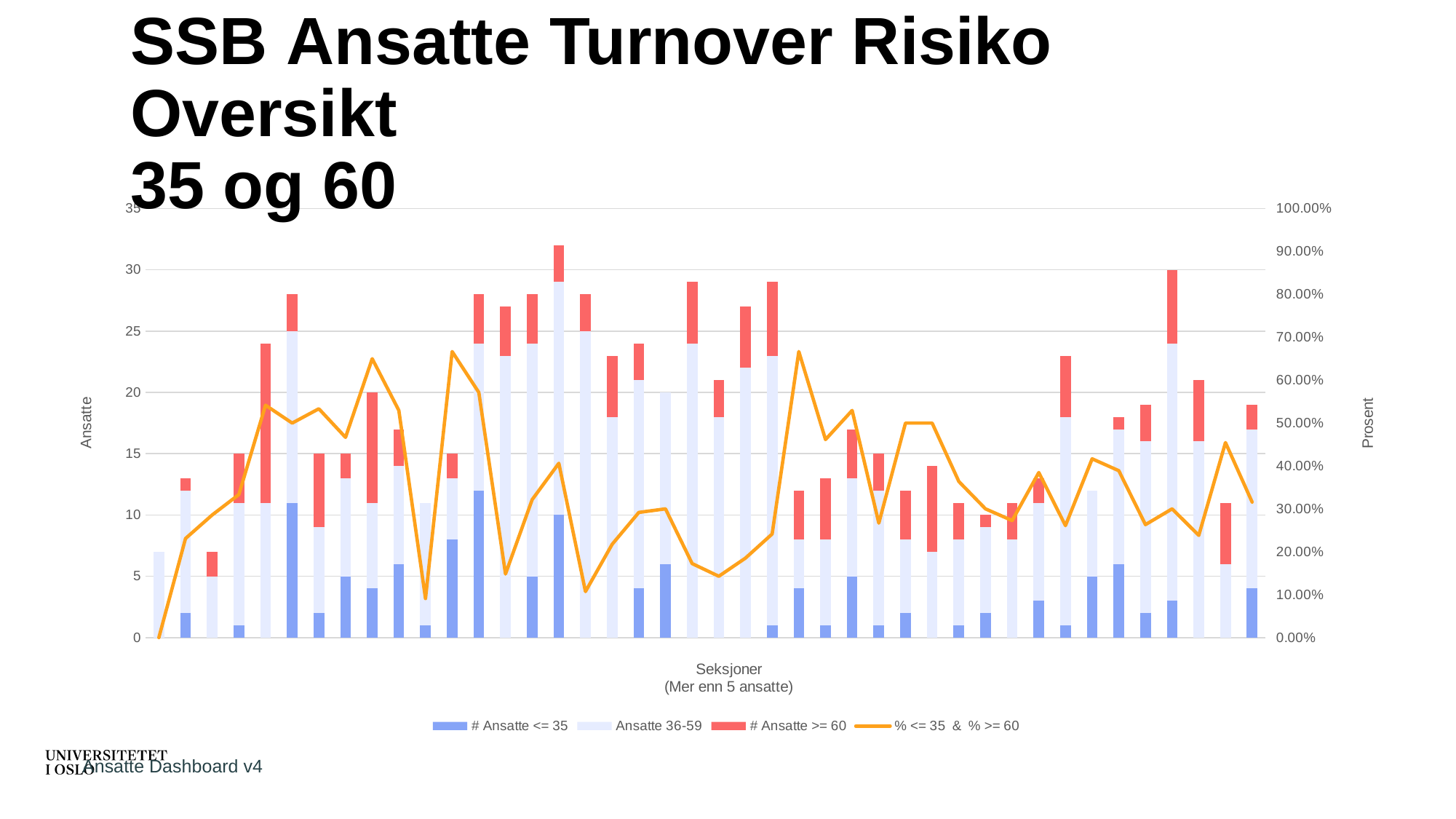
Is the total of the tallest stacked bar greater or less than 30? greater How many series does the legend list? 4 Which series is drawn as the orange line? % <= 35 & % >= 60 Is the lowest point of the orange line greater or less than 10.00%? less What kind of chart is shown on the slide? A combined stacked bar and line chart Is the highest point of the orange line greater or less than 80.00%? less What is the title of the right-hand vertical axis? Prosent